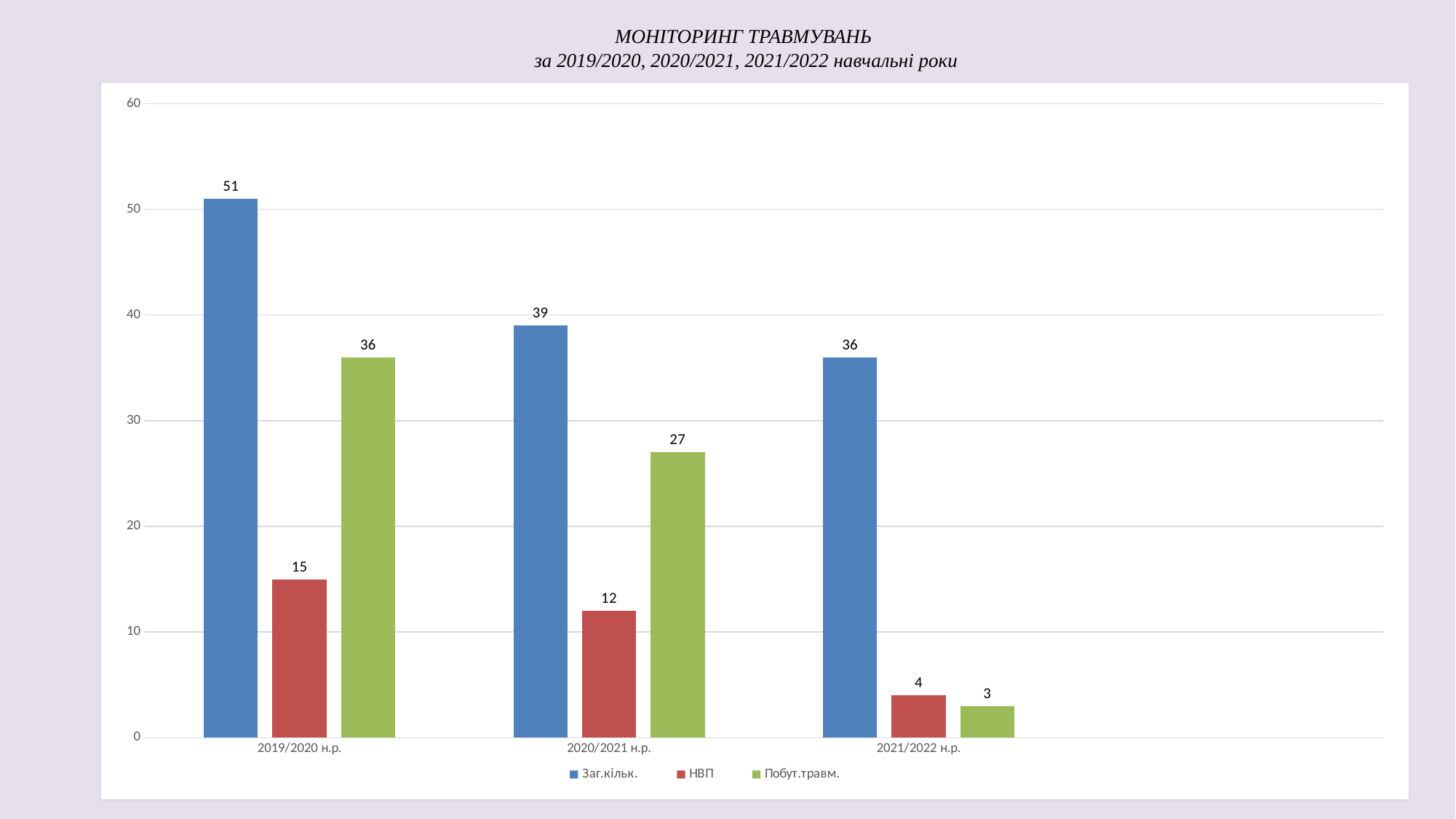
Which is larger for 2019/2020 н.р.: НВП or Побут.травм.? Побут.травм. What is the difference between Заг.кільк. and Побут.травм. for 2020/2021 н.р.? 12 What kind of chart is shown on the slide? bar chart How many series does the legend list? 3 What is the value of Побут.травм. for 2021/2022 н.р.? 3 Which year has the highest value for Заг.кільк.? 2019/2020 н.р. Which year has the lowest value for Побут.травм.? 2021/2022 н.р. What is the value of Заг.кільк. for 2019/2020 н.р.? 51 What is the value of НВП for 2020/2021 н.р.? 12 How many academic years are shown on the x axis? 3 Is the value of Заг.кільк. for 2021/2022 н.р. greater or less than 40? less Does the value of Заг.кільк. rise or fall across the years from 2019/2020 to 2021/2022? fall